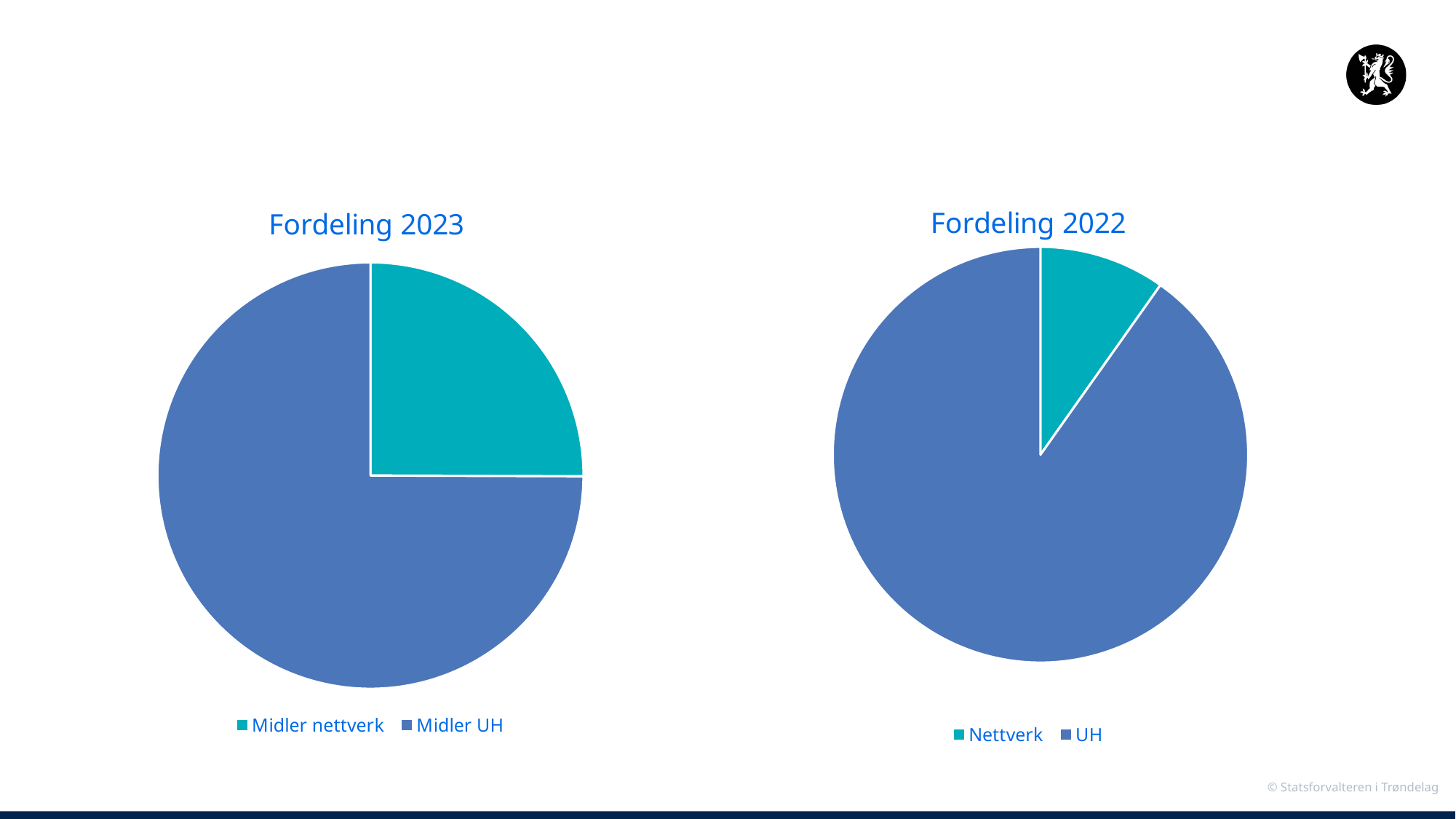
In the "Fordeling 2022" chart, which category has the largest slice? UH In the "Fordeling 2023" chart, which slice is larger, Midler nettverk or Midler UH? Midler UH In the "Fordeling 2022" chart, which category has the smallest slice? Nettverk In the "Fordeling 2023" chart, how many slices does the pie have? 2 In the "Fordeling 2022" chart, which slice is larger, Nettverk or UH? UH What kind of chart is "Fordeling 2023"? pie chart What kind of chart is "Fordeling 2022"? pie chart In the "Fordeling 2022" chart, what colour is the Nettverk slice? teal In the "Fordeling 2023" chart, which category has the smallest slice? Midler nettverk In the "Fordeling 2022" chart, how many categories does the legend list? 2 In the "Fordeling 2023" chart, which category has the largest slice? Midler UH What is the title of the chart on the left side of the slide? Fordeling 2023